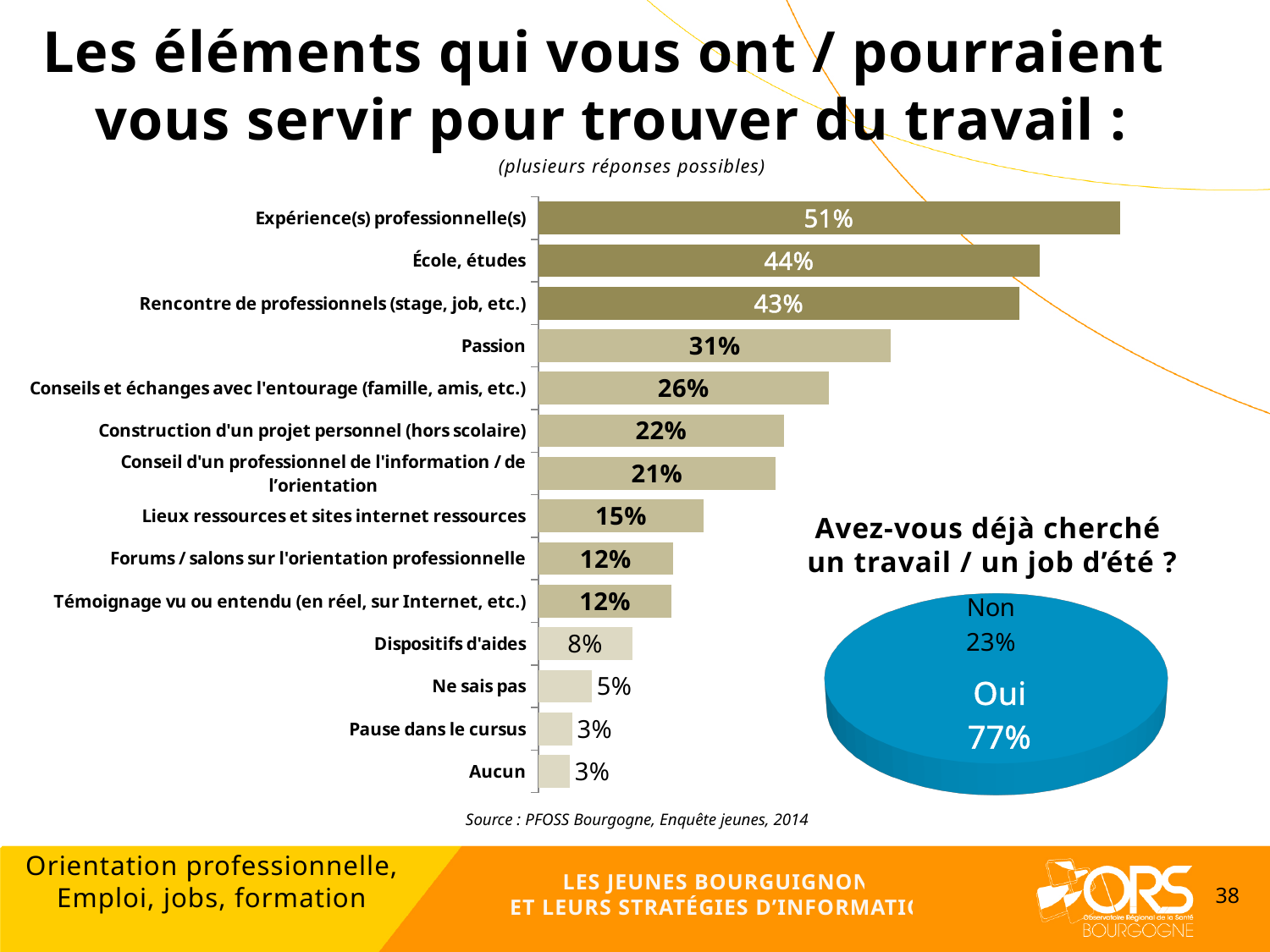
In the bar chart, what is the value for "École, études"? 44% In the bar chart, what is the difference between "Expérience(s) professionnelle(s)" and "Rencontre de professionnels (stage, job, etc.)"? 8% In the pie chart "Avez-vous déjà cherché un travail / un job d'été ?", what share answered "Non"? 23% What source is cited below the bar chart? PFOSS Bourgogne, Enquête jeunes, 2014 In the bar chart, what is the value for "Dispositifs d'aides"? 8% In the bar chart, what is the value for "Passion"? 31% How many categories does the bar chart show? 14 In the pie chart "Avez-vous déjà cherché un travail / un job d'été ?", what share answered "Oui"? 77% What kind of chart is the chart titled "Avez-vous déjà cherché un travail / un job d'été ?"? Pie chart In the bar chart, which is larger: "Conseils et échanges avec l'entourage (famille, amis, etc.)" or "Construction d'un projet personnel (hors scolaire)"? Conseils et échanges avec l'entourage (famille, amis, etc.) What kind of chart is the chart on the left of the slide? Bar chart In the bar chart, which category has the highest value? Expérience(s) professionnelle(s)